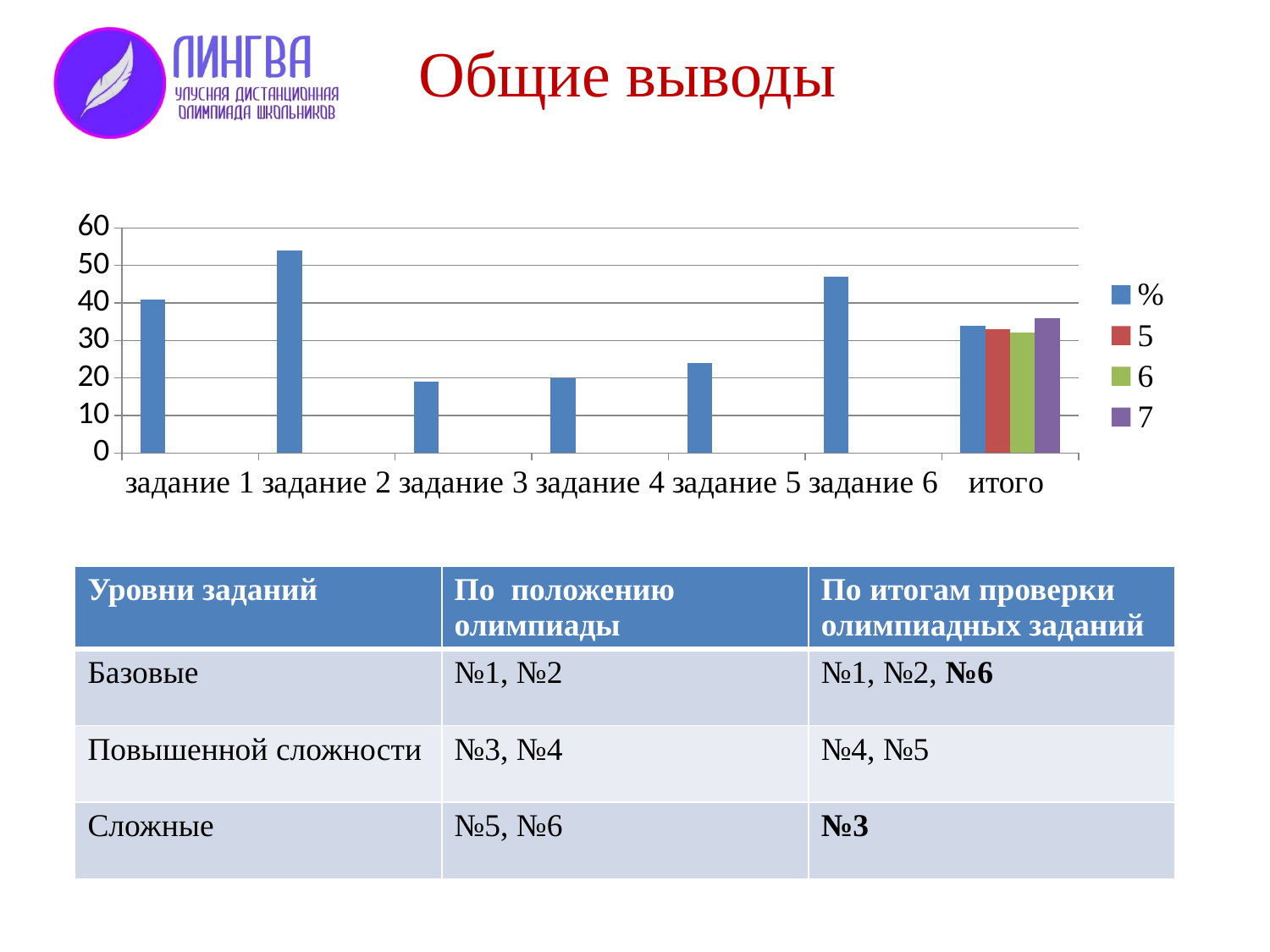
Is the value for задание 5 in the % series greater or less than 30? less How many categories are shown along the x axis of the chart? 7 Which category is the only one with bars for all four series? итого Which is larger in the % series: задание 1 or задание 5? задание 1 What kind of chart is shown on the slide? bar chart Which is larger in the % series: задание 2 or задание 6? задание 2 Is the value for задание 1 in the % series greater or less than 30? greater Is the value for задание 2 in the % series greater or less than 50? greater Which category has the highest value for the % series? задание 2 How many series does the chart legend list? 4